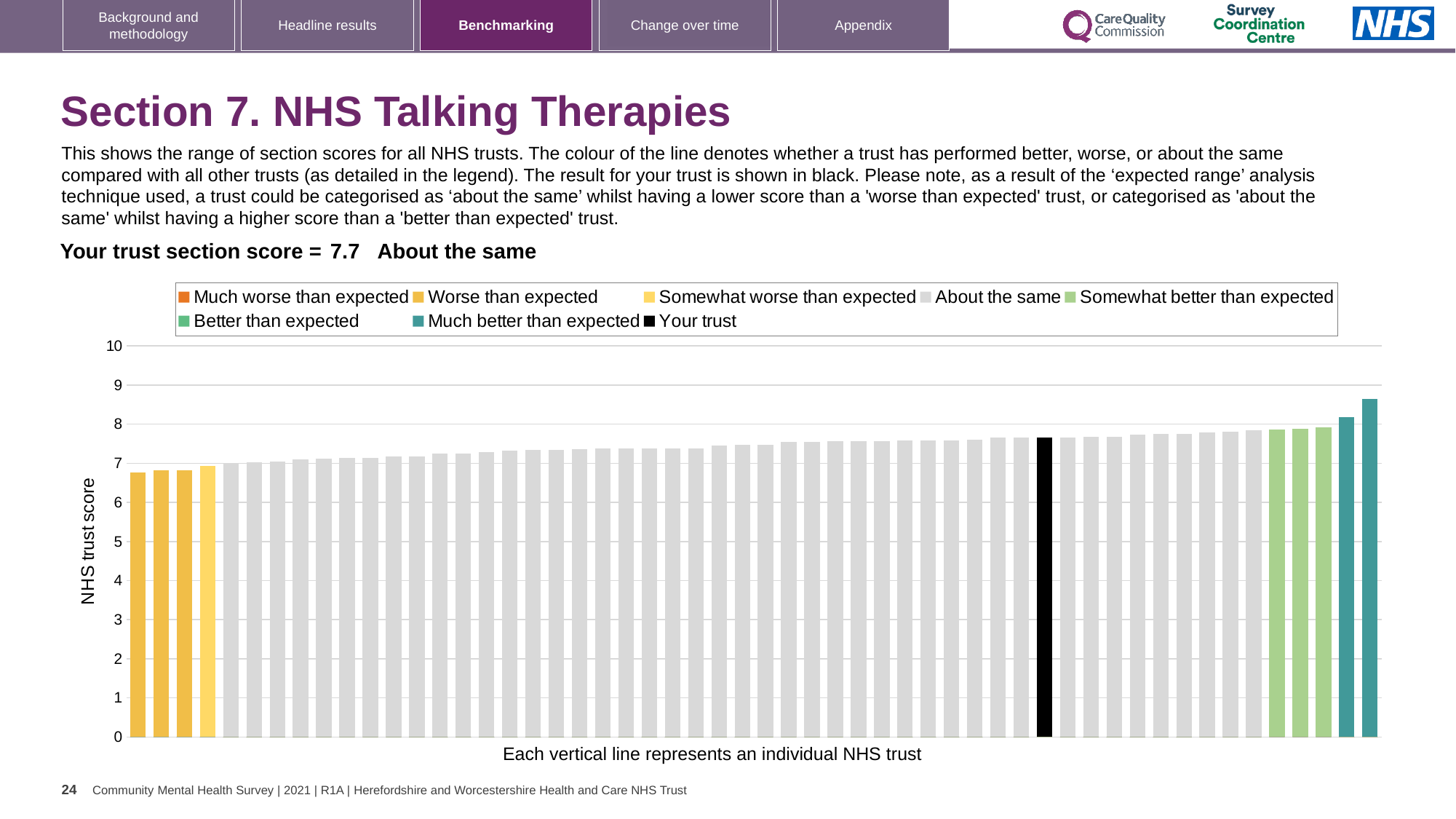
Is the tallest bar in the chart greater or less than 8? greater How many bars are coloured as 'Somewhat better than expected'? 3 Which category is your trust placed in for this section? About the same Do the bar values rise or fall from left to right along the x axis? rise How many entries does the chart legend list? 8 What colour is the bar representing your trust? black Is the shortest bar in the chart greater or less than 7? less What is the label on the vertical axis of the chart? NHS trust score How many bars are coloured as 'Much better than expected'? 2 Is the value for your trust (the black bar) greater or less than 7? greater What is the section score for your trust shown on the slide? 7.7 What kind of chart is shown on the slide? bar chart